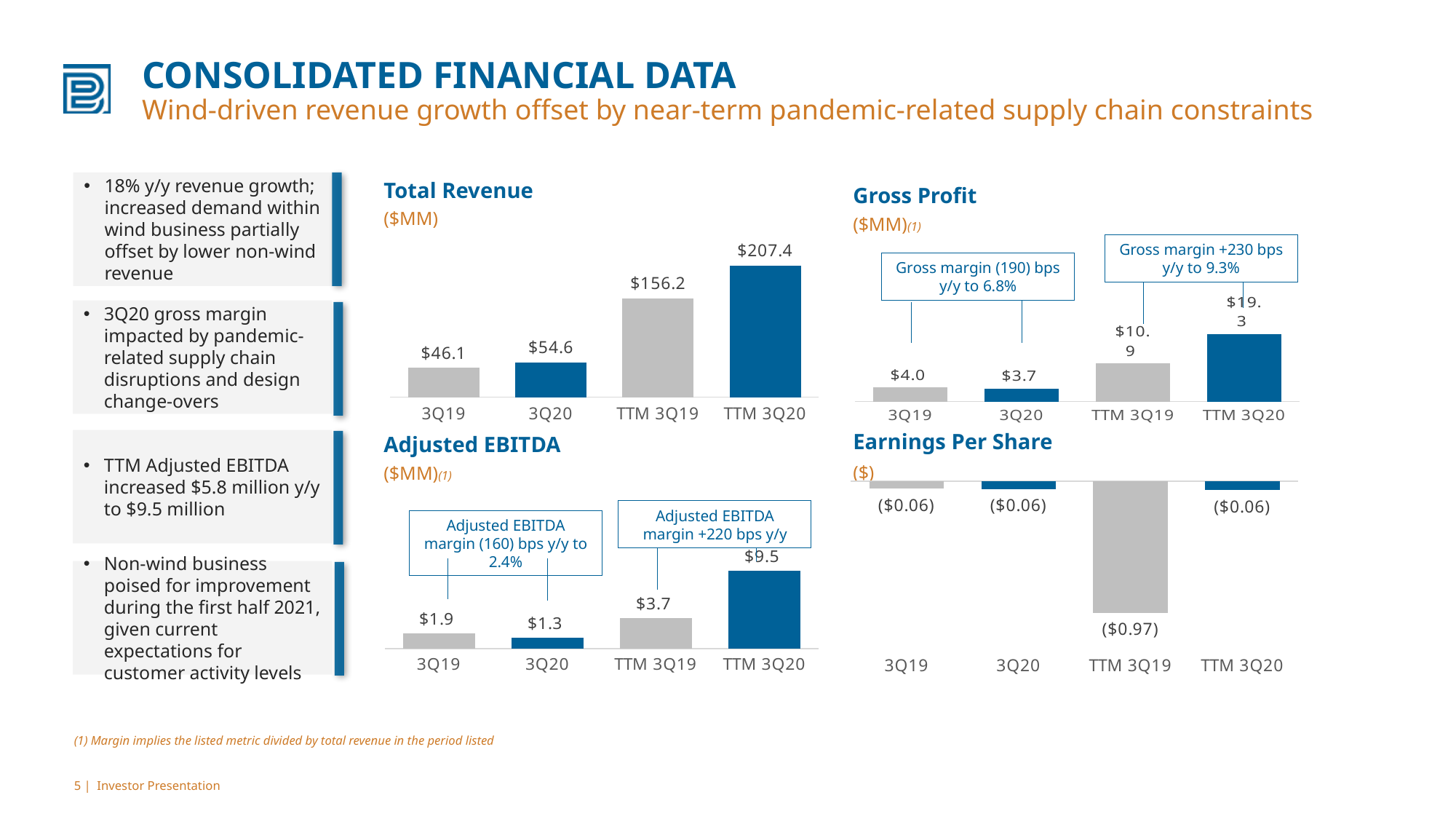
In the Earnings Per Share chart, what is the value for TTM 3Q19? ($0.97) In the Gross Profit chart, which is larger, 3Q19 or 3Q20? 3Q19 In the Total Revenue chart, what is the value for 3Q19? $46.1 In the Gross Profit chart, which period has the highest value? TTM 3Q20 In the Adjusted EBITDA chart, which period has the lowest value? 3Q20 How many periods are shown on the x axis of the Total Revenue chart? 4 In the Adjusted EBITDA chart, what is the value for TTM 3Q20? $9.5 What type of chart is the Earnings Per Share chart? Bar chart In the Total Revenue chart, what is the value for TTM 3Q20? $207.4 In the Gross Profit chart, what is the value for 3Q20? $3.7 In the Adjusted EBITDA chart, what is the difference between TTM 3Q20 and TTM 3Q19? $5.8 In the Total Revenue chart, what is the difference between TTM 3Q20 and TTM 3Q19? $51.2